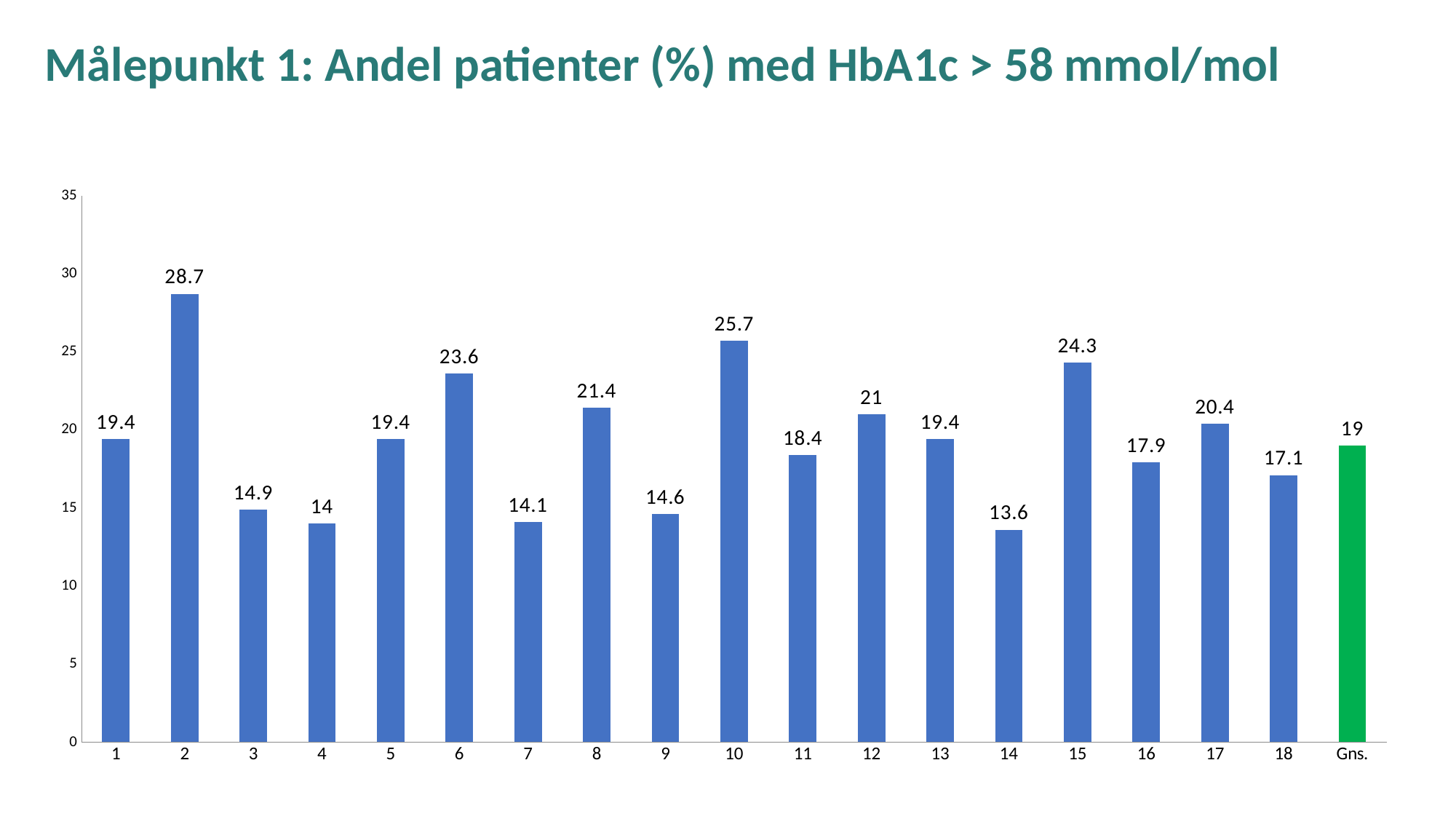
Which bar is coloured green rather than blue? Gns. What is the value for category 14? 13.6 Which category has the lowest value? 14 How many bars are shown in the chart? 19 What is the difference between the values for category 2 and category 14? 15.1 Is the value for category 6 greater or less than 20? greater What kind of chart is shown on the slide? bar chart What is the title of the chart on the slide? Målepunkt 1: Andel patienter (%) med HbA1c > 58 mmol/mol Which is larger, the value for category 10 or the value for category 15? 10 What is the value for the Gns. bar? 19 What is the value for category 2? 28.7 Which category has the highest value? 2